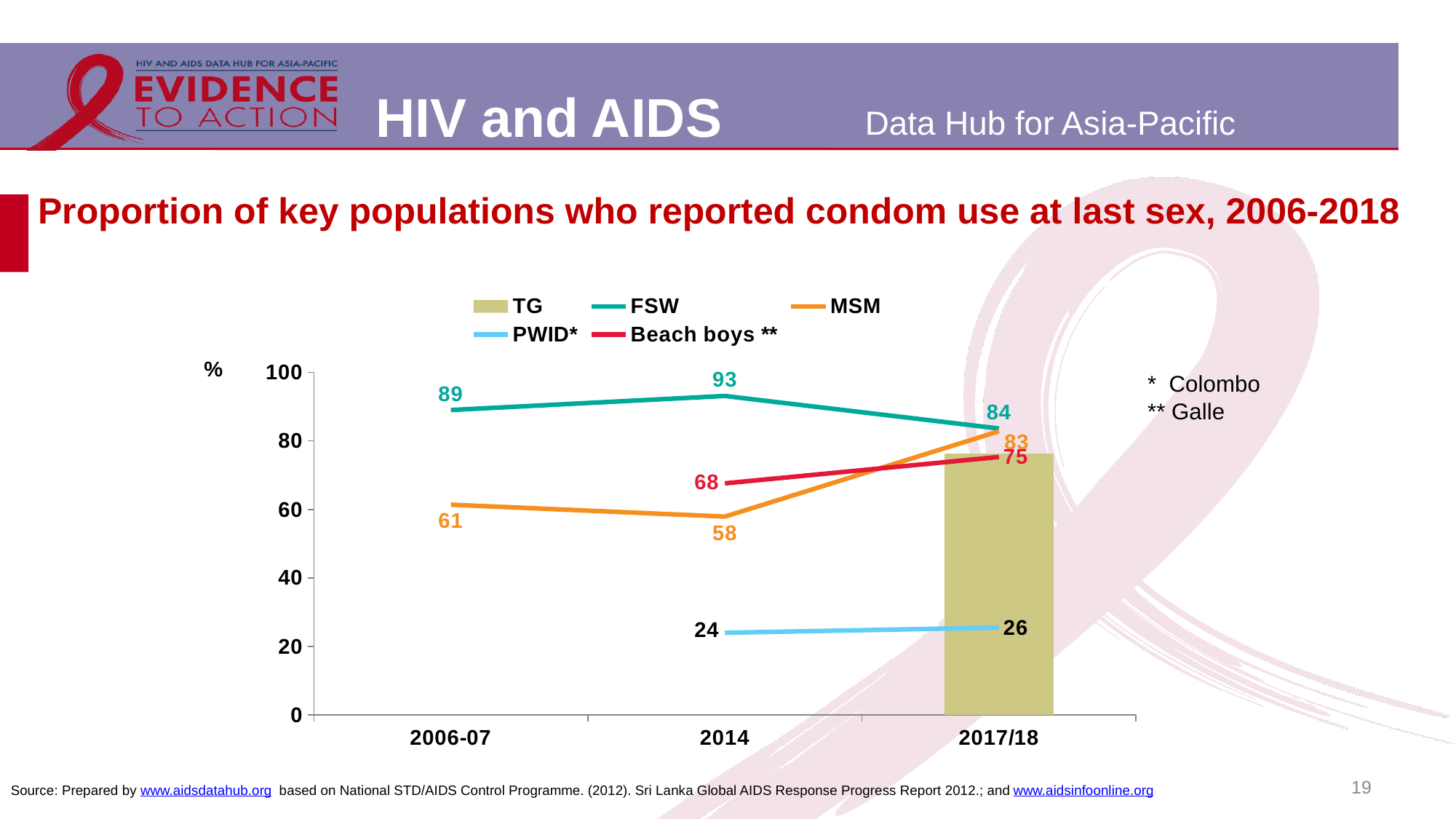
What is the difference between the MSM values in 2017/18 and 2014? 25 Which series has the highest value in 2017/18? FSW How many series does the legend list? 5 What value is shown for MSM in 2006-07? 61 What value is shown for FSW in 2014? 93 What value is shown for PWID* in 2014? 24 Does the FSW value rise or fall from 2014 to 2017/18? fall What value is shown for Beach boys ** in 2017/18? 75 Is the value of the TG bar in 2017/18 greater or less than 60? greater Which is larger in 2014, the FSW value or the Beach boys ** value? FSW Which series has the lowest value in 2014? PWID* How many time periods are shown on the x axis? 3